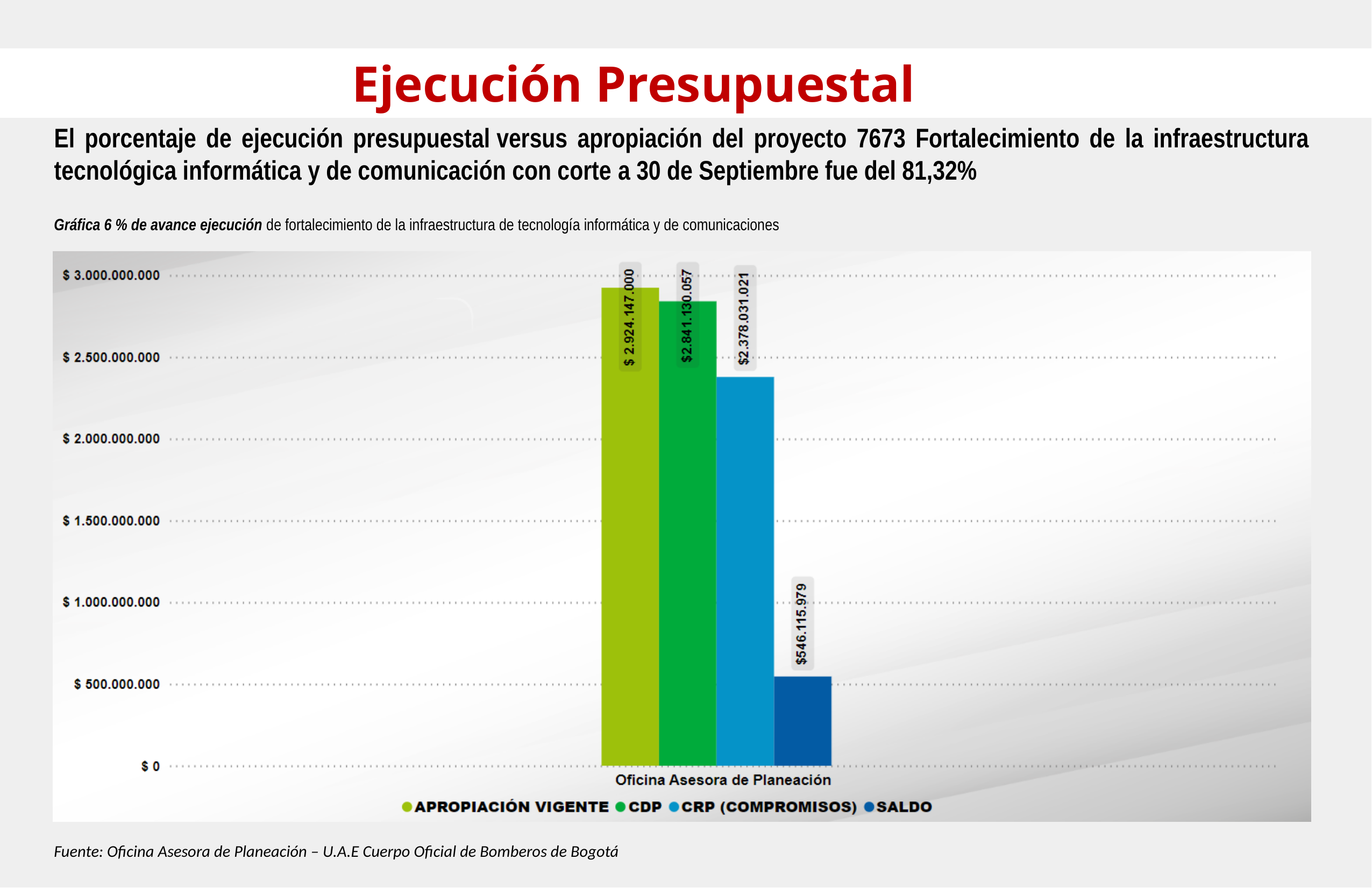
What is the value of SALDO for Oficina Asesora de Planeación? $546.115.979 What is the value of CRP (COMPROMISOS) for Oficina Asesora de Planeación? $2.378.031.021 What is the difference between APROPIACIÓN VIGENTE and CDP? $83.016.943 Which series has the highest value in the chart? APROPIACIÓN VIGENTE Is the value for SALDO greater or less than $ 1.000.000.000? less What kind of chart is shown on the slide? Bar chart Which is larger, CDP or CRP (COMPROMISOS)? CDP How many series does the legend list? 4 What is the value of APROPIACIÓN VIGENTE for Oficina Asesora de Planeación? $ 2.924.147.000 Which series has the lowest value in the chart? SALDO What is the value of CDP for Oficina Asesora de Planeación? $2.841.130.057 What is the difference between CRP (COMPROMISOS) and SALDO? $1.831.915.042